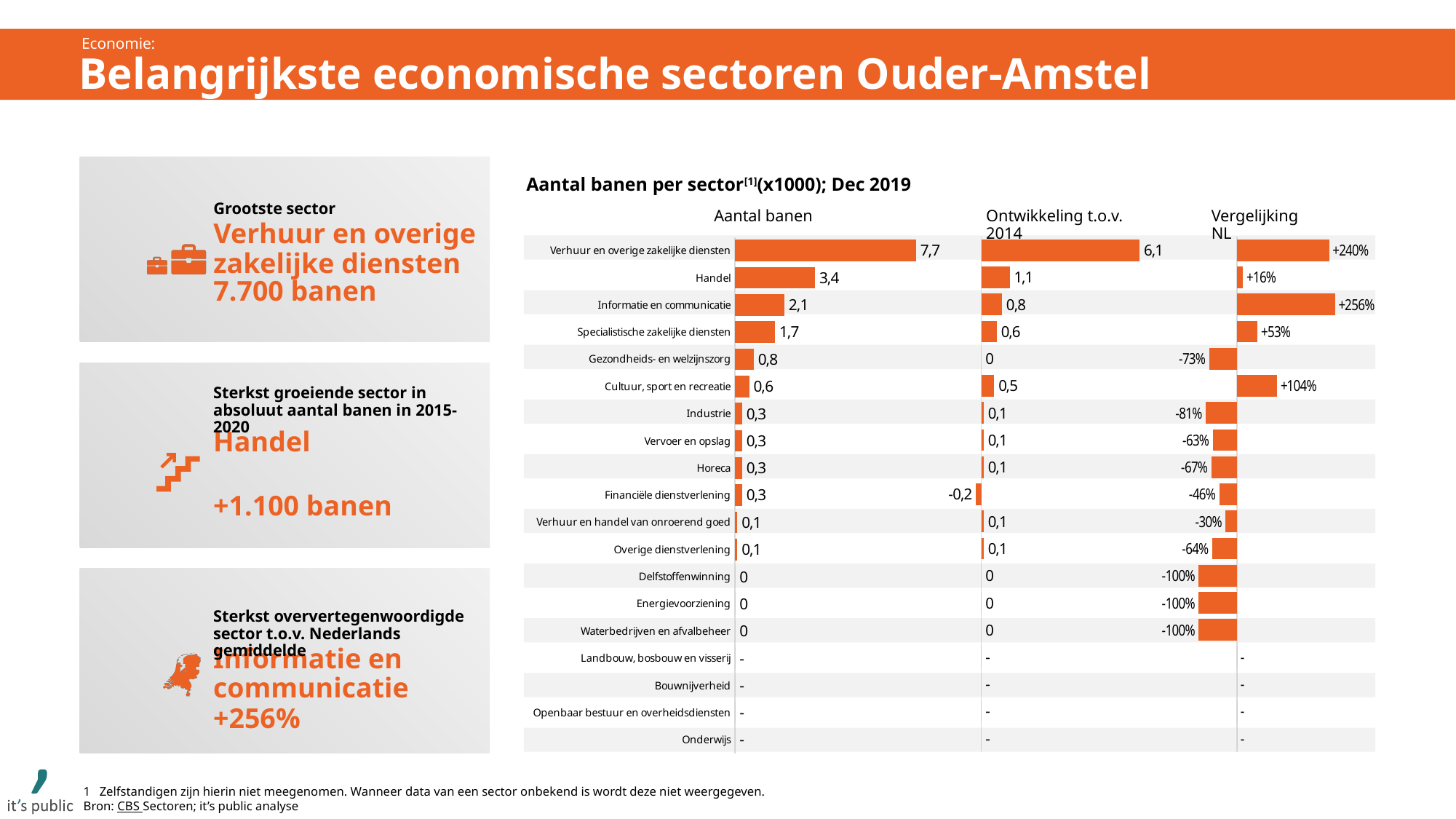
In the 'Aantal banen' chart, which sector has the highest value? Verhuur en overige zakelijke diensten In the 'Vergelijking NL' chart, what is the value for Informatie en communicatie? +256% In the 'Ontwikkeling t.o.v. 2014' chart, what is the value for Cultuur, sport en recreatie? 0,5 How many sectors are listed as rows in the charts? 19 In the 'Ontwikkeling t.o.v. 2014' chart, which sector has the lowest value? Financiële dienstverlening In the 'Aantal banen' chart, what is the value for Handel? 3,4 In the 'Aantal banen' chart, what is the difference between Verhuur en overige zakelijke diensten and Handel? 4,3 In the 'Vergelijking NL' chart, which sector has the highest value? Informatie en communicatie In the 'Vergelijking NL' chart, which is larger: the value for Cultuur, sport en recreatie or the value for Specialistische zakelijke diensten? Cultuur, sport en recreatie What kind of chart is used for 'Aantal banen'? Bar chart What is the title above the three charts? Aantal banen per sector (x1000); Dec 2019 In the 'Ontwikkeling t.o.v. 2014' chart, what is the value for Financiële dienstverlening? -0,2